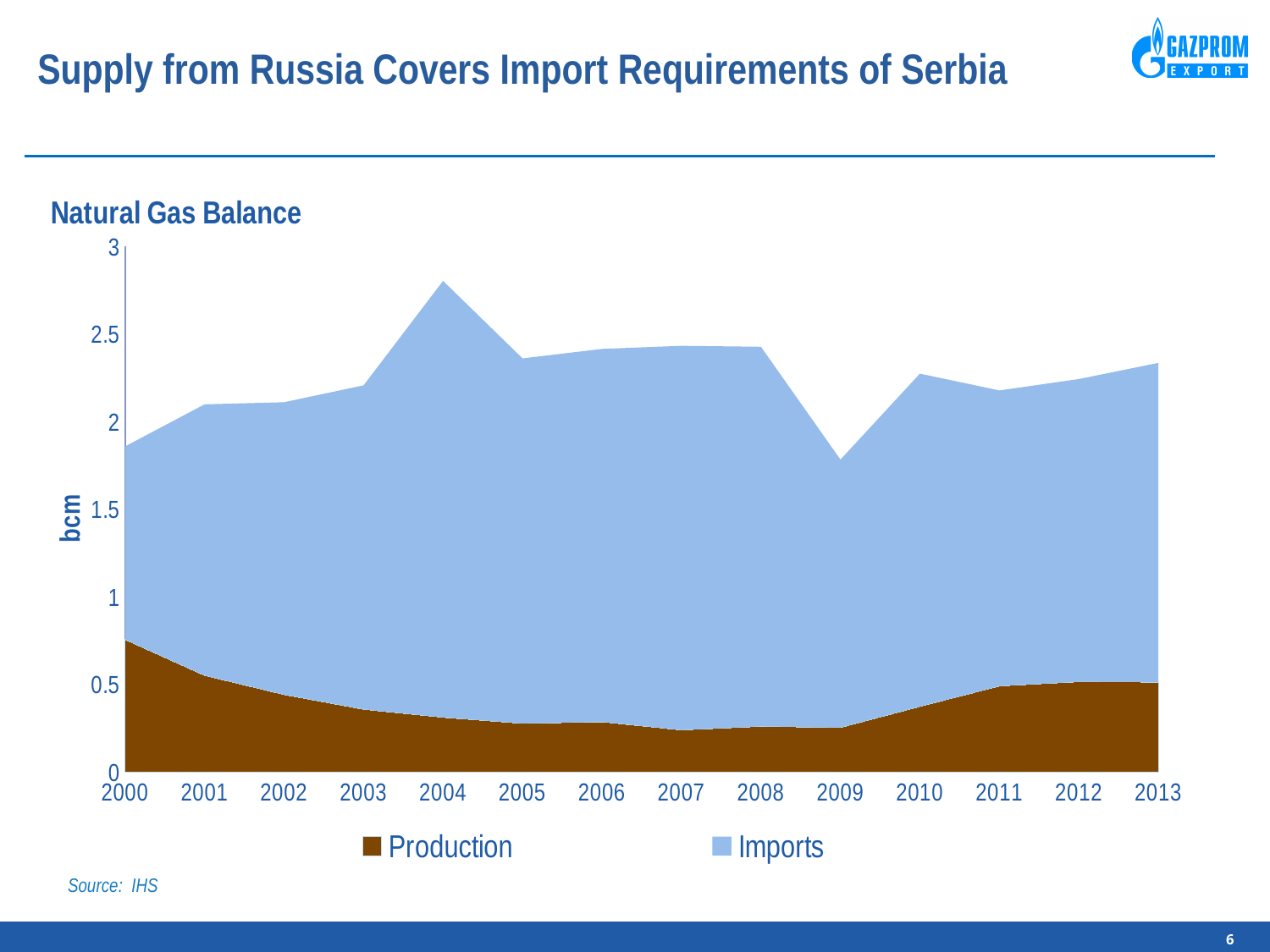
Is the total (production plus imports) in 2004 greater or less than 2.5? greater What kind of chart is shown on the slide? Stacked area chart Is the value for Production in 2000 greater or less than 0.5? greater Does Production rise or fall from 2000 to 2007? fall Which is larger, Production in 2000 or Production in 2013? 2000 What unit is shown on the y axis? bcm In which year is Production highest? 2000 Is the total (production plus imports) in 2009 greater or less than 2? less In which year is the total natural gas balance (production plus imports) highest? 2004 How many series does the legend list? 2 How many years are shown on the x axis? 14